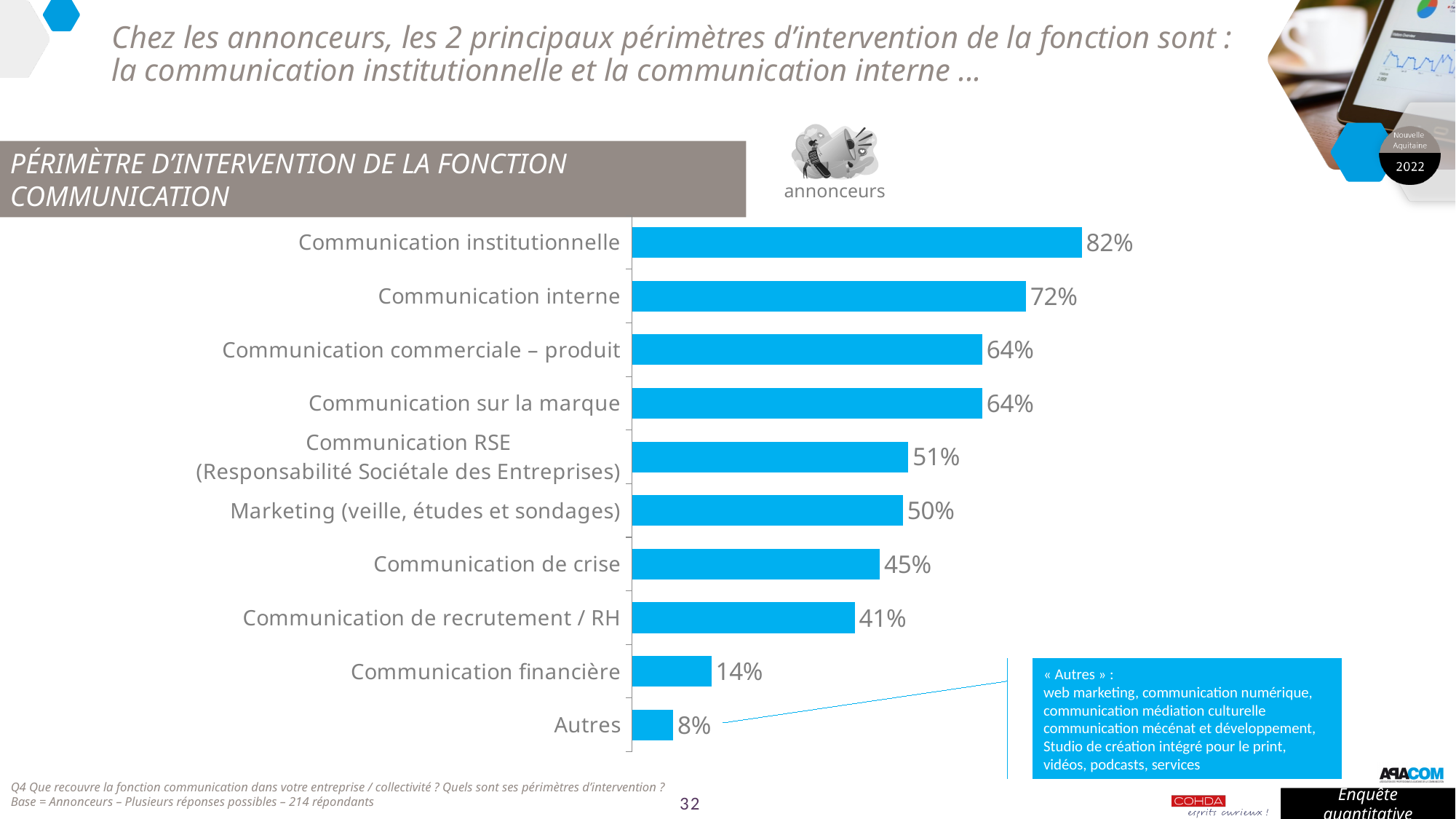
Which category has the highest value? Communication institutionnelle What is the difference between Communication RSE (Responsabilité Sociétale des Entreprises) and Marketing (veille, études et sondages)? 1% Which category has the lowest value? Autres What is the value for Communication de crise? 45% What is the value for Communication institutionnelle? 82% Which is larger, Communication de crise or Communication de recrutement / RH? Communication de crise What is the value for Communication financière? 14% What is the value for Communication interne? 72% How many categories are shown in the chart? 10 What is the title of the chart? PÉRIMÈTRE D'INTERVENTION DE LA FONCTION COMMUNICATION What is the difference between Communication institutionnelle and Communication interne? 10% What kind of chart is shown on the slide? Bar chart